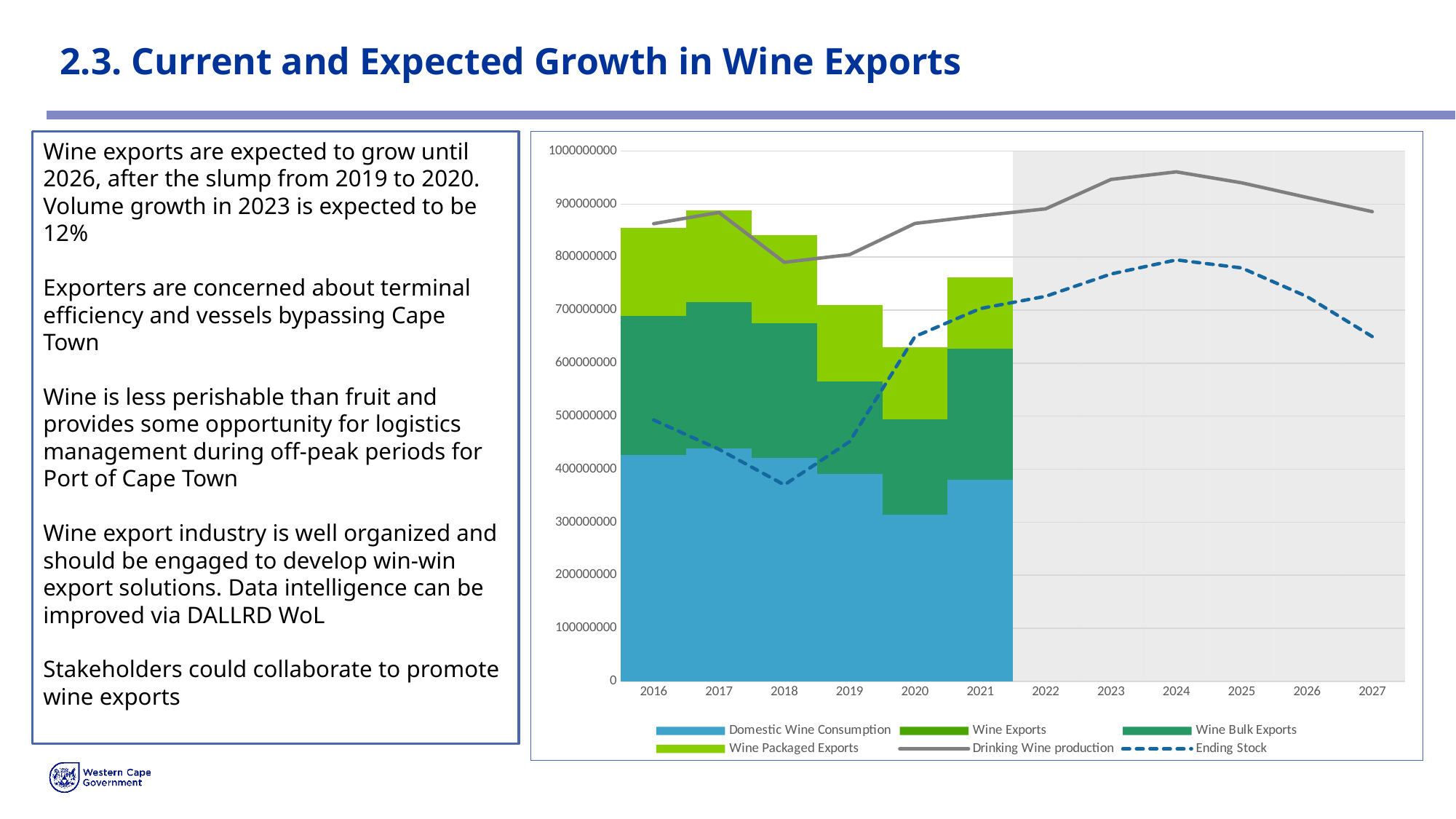
Is the Ending Stock value for 2018 greater or less than 400000000? less How many years are shown on the x axis? 12 Which years on the x axis are covered by the grey shaded area? 2022 to 2027 Does Ending Stock rise or fall from 2018 to 2024? rise What kind of chart is this? Stacked bar chart with line series Which is larger, Domestic Wine Consumption in 2016 or in 2020? 2016 How many series does the legend list? 6 In which year is Drinking Wine production highest? 2024 Is the Domestic Wine Consumption value for 2020 greater or less than 400000000? less In which year is Ending Stock lowest? 2018 Which year has the tallest stacked bar? 2017 Is the Drinking Wine production value for 2024 greater or less than 900000000? greater